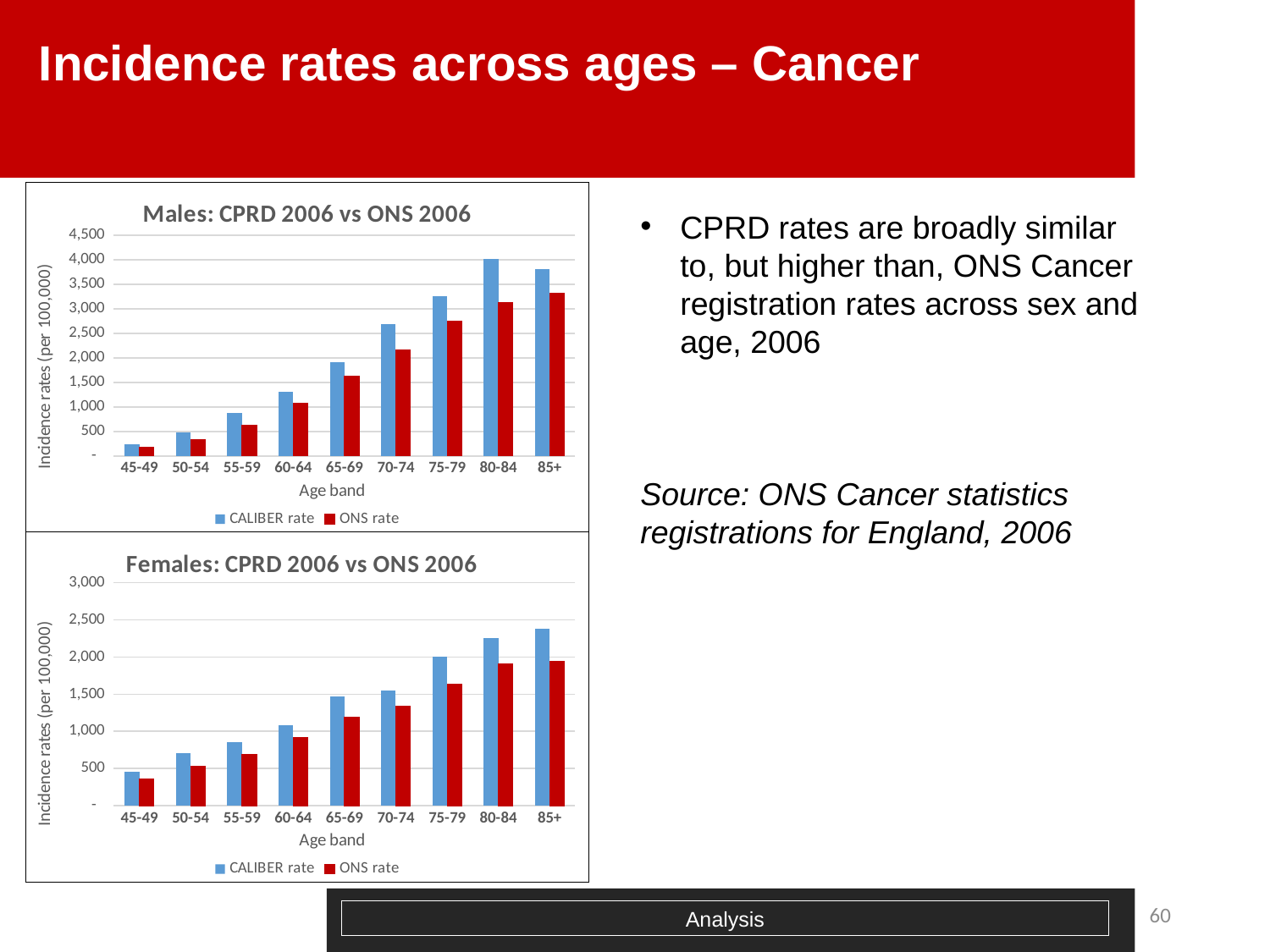
How many series does the legend of the Males: CPRD 2006 vs ONS 2006 chart list? 2 On the Males: CPRD 2006 vs ONS 2006 chart, which age band has the highest CALIBER rate? 80-84 How many age bands are shown on the Females: CPRD 2006 vs ONS 2006 chart? 9 On the Females: CPRD 2006 vs ONS 2006 chart, is the CALIBER rate for 60-64 greater or less than 1,000? greater On the Females: CPRD 2006 vs ONS 2006 chart, which age band has the lowest CALIBER rate? 45-49 On the Males: CPRD 2006 vs ONS 2006 chart, which is larger for the 80-84 age band, the CALIBER rate or the ONS rate? CALIBER rate On the Males: CPRD 2006 vs ONS 2006 chart, which age band has the lowest ONS rate? 45-49 On the Females: CPRD 2006 vs ONS 2006 chart, which age band has the highest CALIBER rate? 85+ On the Males: CPRD 2006 vs ONS 2006 chart, is the CALIBER rate for 70-74 greater or less than 2,500? greater On the Females: CPRD 2006 vs ONS 2006 chart, is the ONS rate for 70-74 greater or less than 1,500? less What kind of chart is the Females: CPRD 2006 vs ONS 2006 chart? Bar chart